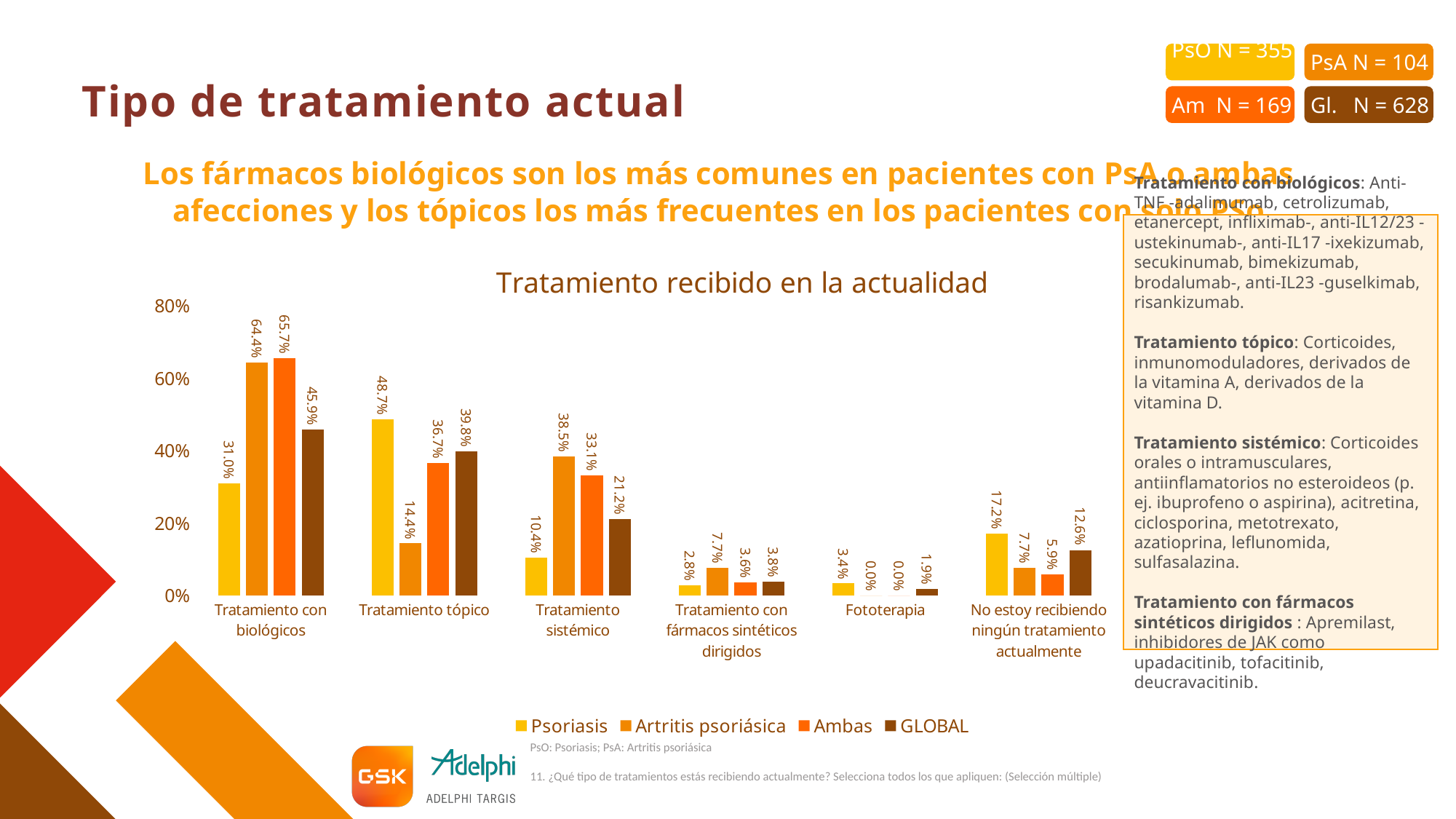
What is the GLOBAL value for 'Tratamiento tópico'? 39.8% What is the value for Artritis psoriásica in the 'Tratamiento sistémico' category? 38.5% What kind of chart is shown on the slide? Bar chart In the 'No estoy recibiendo ningún tratamiento actualmente' category, which is larger: the Psoriasis value or the GLOBAL value? Psoriasis What is the value for Psoriasis in the 'Tratamiento con biológicos' category? 31.0% Which category has the highest value for the Psoriasis series? Tratamiento tópico What is the value for Ambas in the 'Fototerapia' category? 0.0% How many series does the legend list? 4 Which category has the lowest GLOBAL value? Fototerapia What is the difference between the Artritis psoriásica and Psoriasis values for 'Tratamiento con biológicos'? 33.4% How many treatment categories are shown on the x axis? 6 What is the title of the chart? Tratamiento recibido en la actualidad